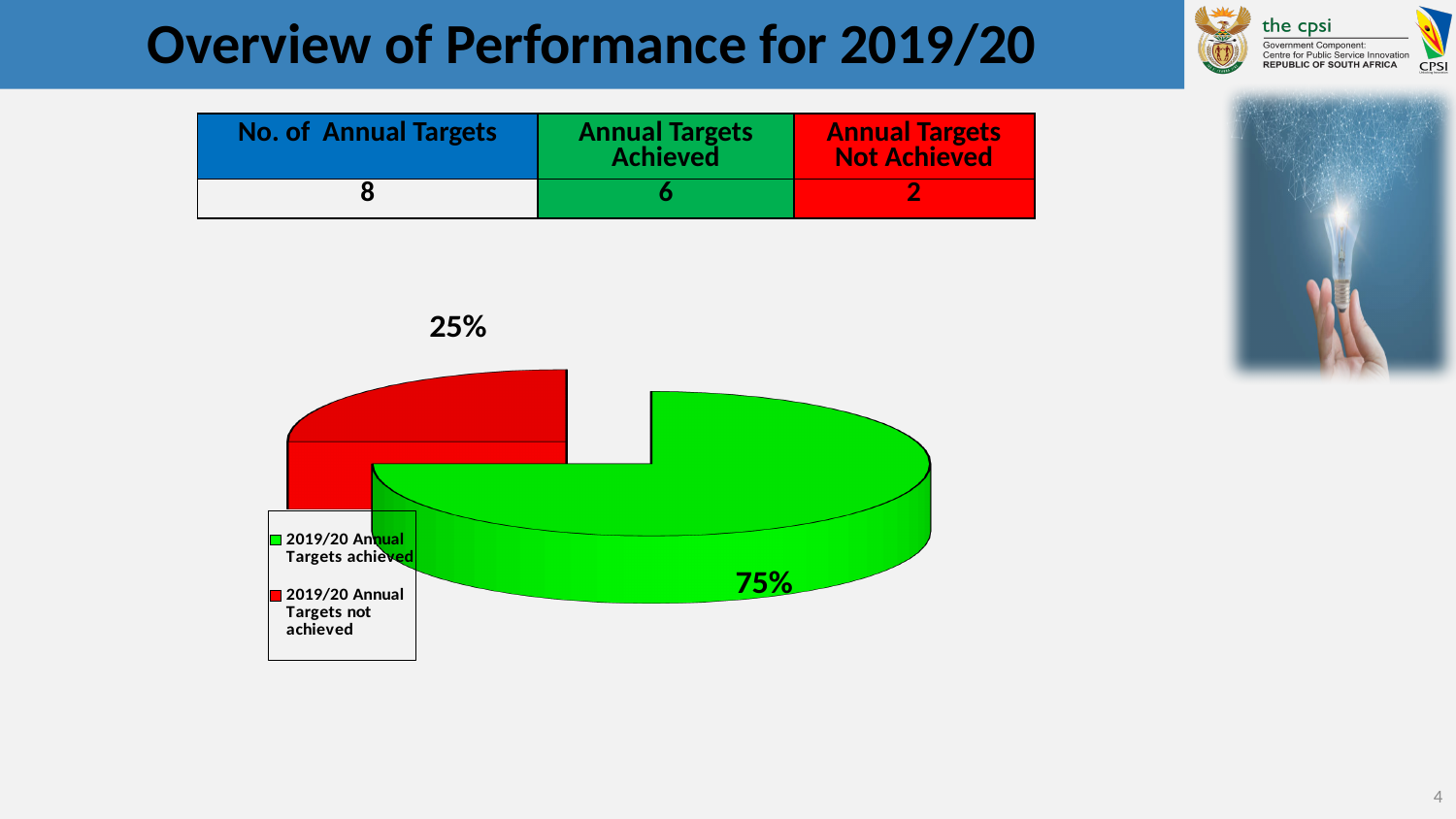
What colour is the '2019/20 Annual Targets not achieved' slice in the pie chart? Red Which is larger: the share for 'Targets achieved' or the share for 'Targets not achieved'? 2019/20 Annual Targets achieved What kind of chart is shown on the slide? Pie chart What colour is the '2019/20 Annual Targets achieved' slice in the pie chart? Green How many slices does the pie chart have? 2 Which slice of the pie chart is the largest? 2019/20 Annual Targets achieved How many entries does the legend of the pie chart list? 2 What share of the pie does '2019/20 Annual Targets achieved' represent? 75% Which slice of the pie chart is the smallest? 2019/20 Annual Targets not achieved What is the difference in percentage points between the 'Targets achieved' slice and the 'Targets not achieved' slice? 50 percentage points What share of the pie does '2019/20 Annual Targets not achieved' represent? 25%